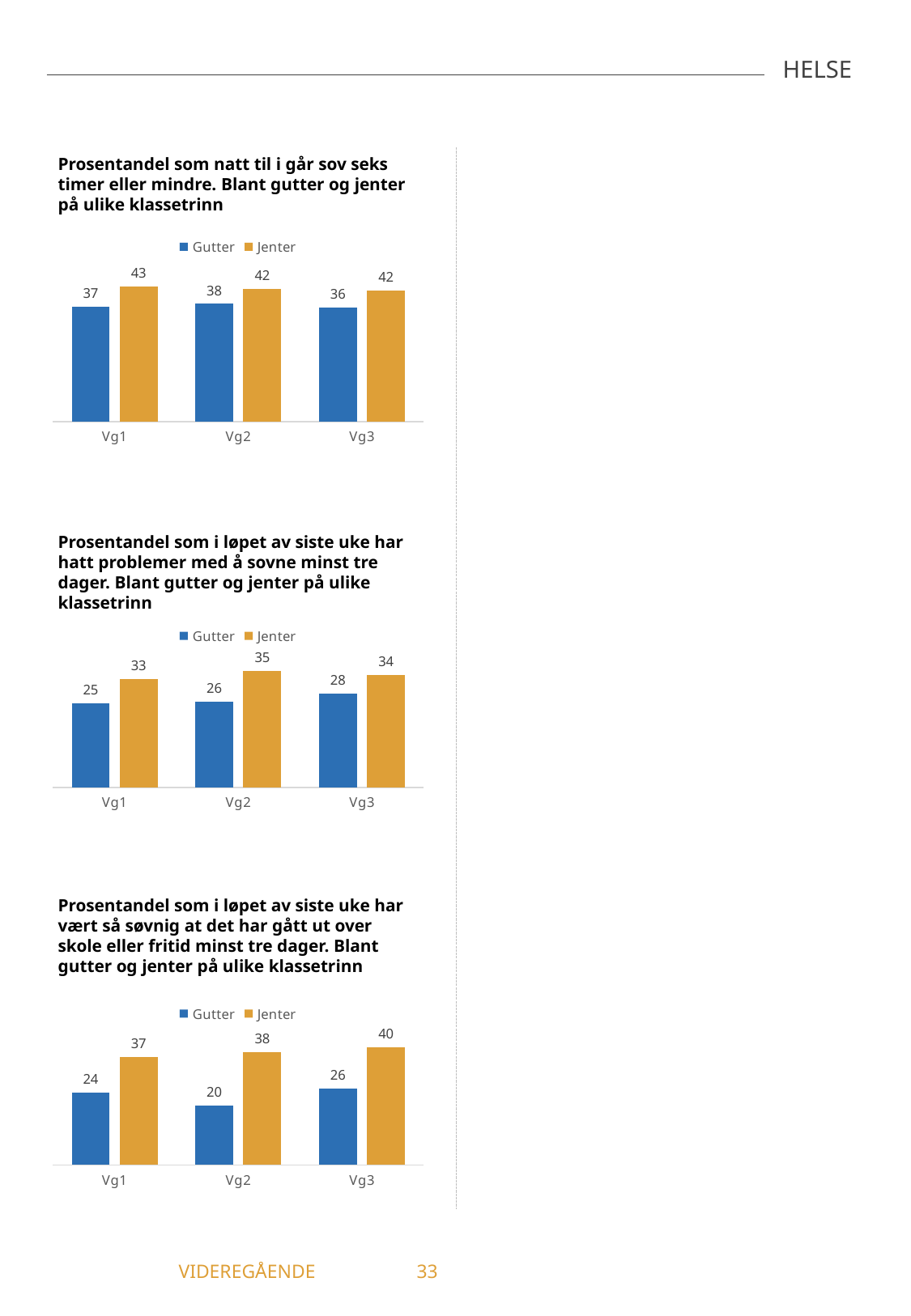
In the top chart (sleeping six hours or less), what is the value for Jenter at Vg1? 43 In the top chart (sleeping six hours or less), what is the value for Gutter at Vg3? 36 In the bottom chart (so sleepy it affected school or leisure), do the Jenter values rise or fall from Vg1 to Vg3? rise In the middle chart (problems falling asleep), what is the value for Gutter at Vg3? 28 What kind of chart is the middle chart (problems falling asleep)? bar chart In the middle chart (problems falling asleep), which grade has the highest value for Jenter? Vg2 In the middle chart (problems falling asleep), which grade has the lowest value for Gutter? Vg1 In the top chart (sleeping six hours or less), what is the difference between Jenter and Gutter at Vg1? 6 In the bottom chart (so sleepy it affected school or leisure), what is the value for Jenter at Vg3? 40 In the bottom chart (so sleepy it affected school or leisure), what is the difference between Jenter and Gutter at Vg2? 18 In the bottom chart (so sleepy it affected school or leisure), which grade has the lowest value for Gutter? Vg2 How many series does the legend of the top chart list? 2